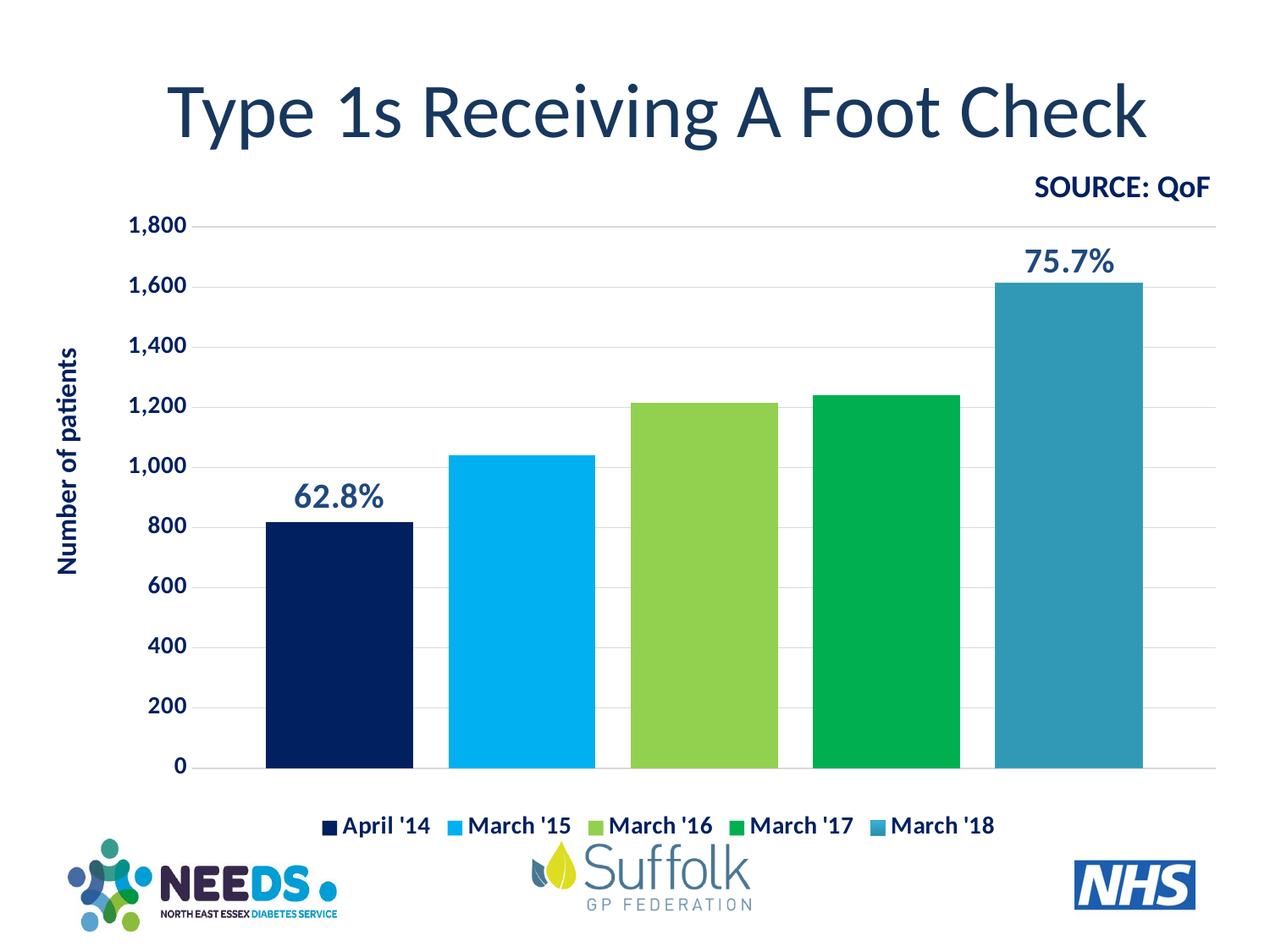
By how many percentage points does the March '18 label exceed the April '14 label? 12.9 Which period has the highest number of patients? March '18 What percentage label is shown above the April '14 bar? 62.8% Which period has the lowest number of patients? April '14 Is the number of patients for April '14 greater or less than 1,000? less How many entries does the legend list? 5 What percentage label is shown above the March '18 bar? 75.7% What kind of chart is shown on the slide? bar chart How many bars are plotted in the chart? 5 What is the label on the vertical axis? Number of patients Is the number of patients for March '18 greater or less than 1,400? greater Do the values rise or fall from April '14 to March '18? rise